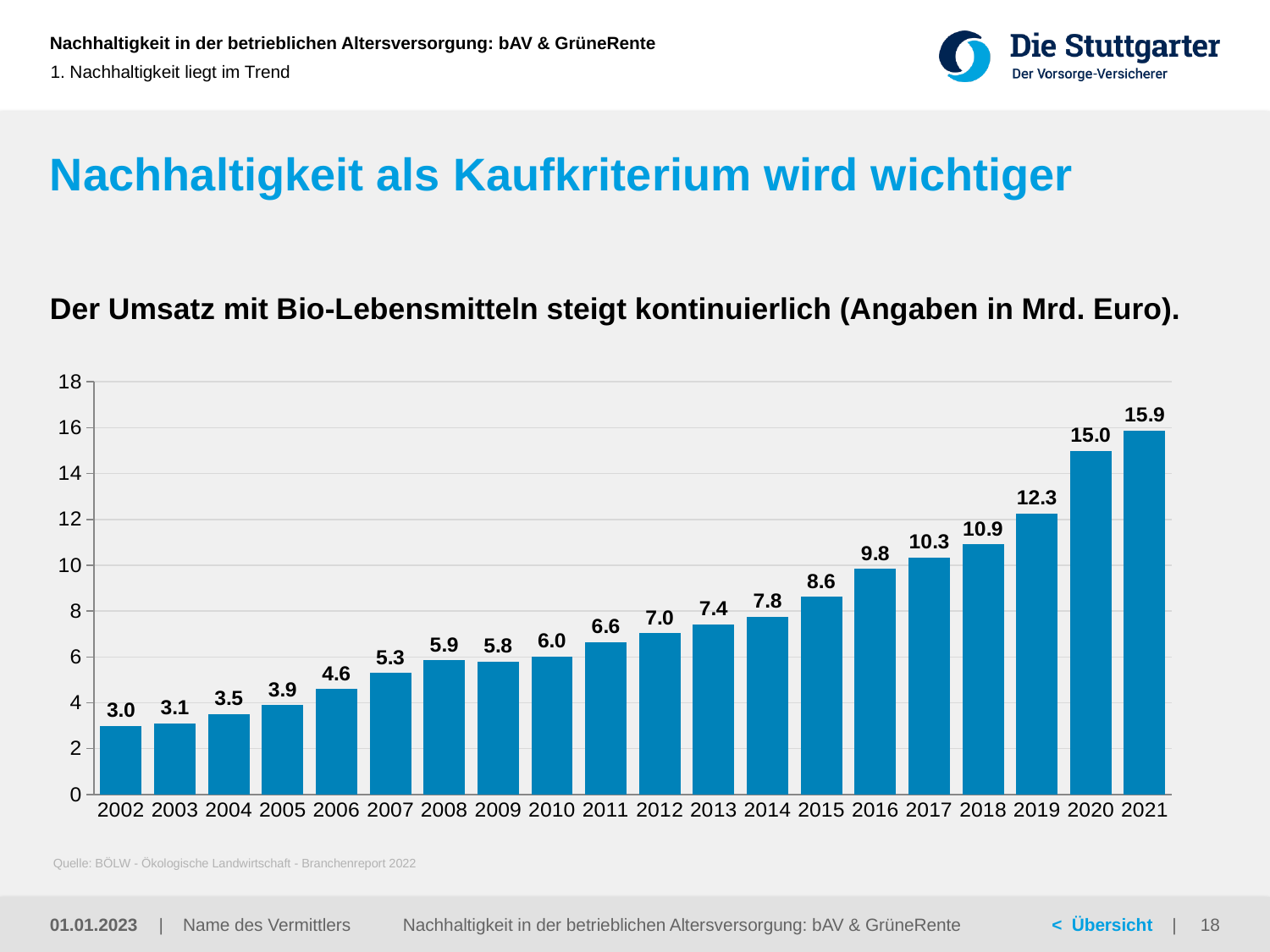
Which year has the lowest value? 2002 What kind of chart is shown on the slide? bar chart How many years are shown on the x axis? 20 What is the difference between the values for 2021 and 2020? 0.9 Which is larger, the value for 2008 or the value for 2009? 2008 What is the difference between the values for 2015 and 2014? 0.8 Which year has the highest value? 2021 What is the value for 2002? 3.0 Do the values generally rise or fall from 2002 to 2021? rise Is the value for 2016 greater or less than 10? less What is the value for 2019? 12.3 What is the value for 2010? 6.0